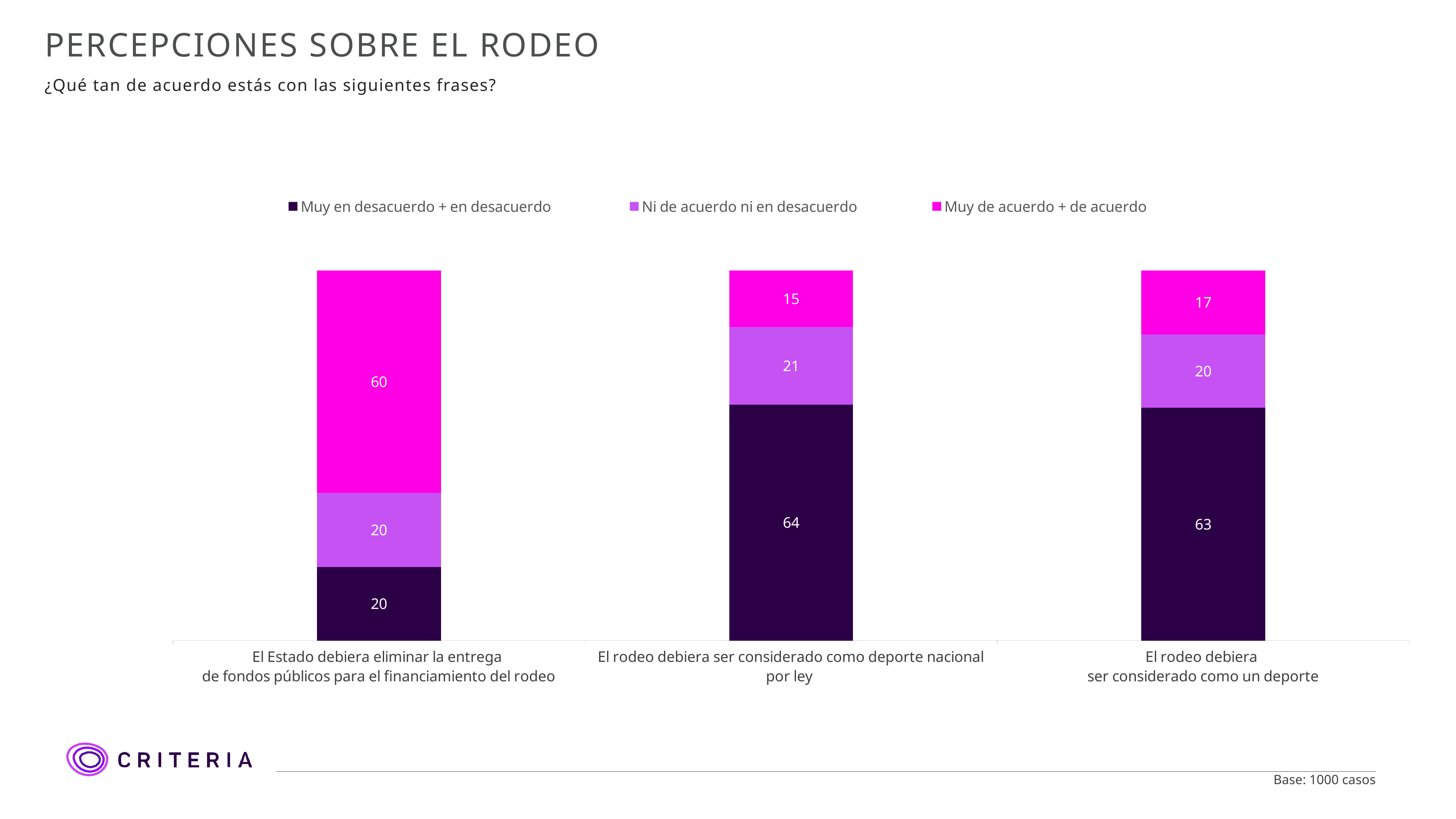
What is the value of 'Ni de acuerdo ni en desacuerdo' for 'El rodeo debiera ser considerado como un deporte'? 20 Which is larger: 'Muy de acuerdo + de acuerdo' for 'El rodeo debiera ser considerado como deporte nacional por ley' or for 'El rodeo debiera ser considerado como un deporte'? El rodeo debiera ser considerado como un deporte What is the value of 'Muy de acuerdo + de acuerdo' for 'El Estado debiera eliminar la entrega de fondos públicos para el financiamiento del rodeo'? 60 How many categories are shown on the x axis? 3 Which category has the lowest value for 'Muy de acuerdo + de acuerdo'? El rodeo debiera ser considerado como deporte nacional por ley What is the value of 'Muy de acuerdo + de acuerdo' for 'El rodeo debiera ser considerado como un deporte'? 17 What kind of chart is shown on the slide? Stacked bar chart What is the value of 'Muy en desacuerdo + en desacuerdo' for 'El rodeo debiera ser considerado como deporte nacional por ley'? 64 How many series does the legend list? 3 Which category has the highest value for 'Muy de acuerdo + de acuerdo'? El Estado debiera eliminar la entrega de fondos públicos para el financiamiento del rodeo What is the total of the stacked bar for 'El rodeo debiera ser considerado como deporte nacional por ley'? 100 What is the difference between the 'Muy en desacuerdo + en desacuerdo' values for 'El rodeo debiera ser considerado como deporte nacional por ley' and 'El Estado debiera eliminar la entrega de fondos públicos para el financiamiento del rodeo'? 44